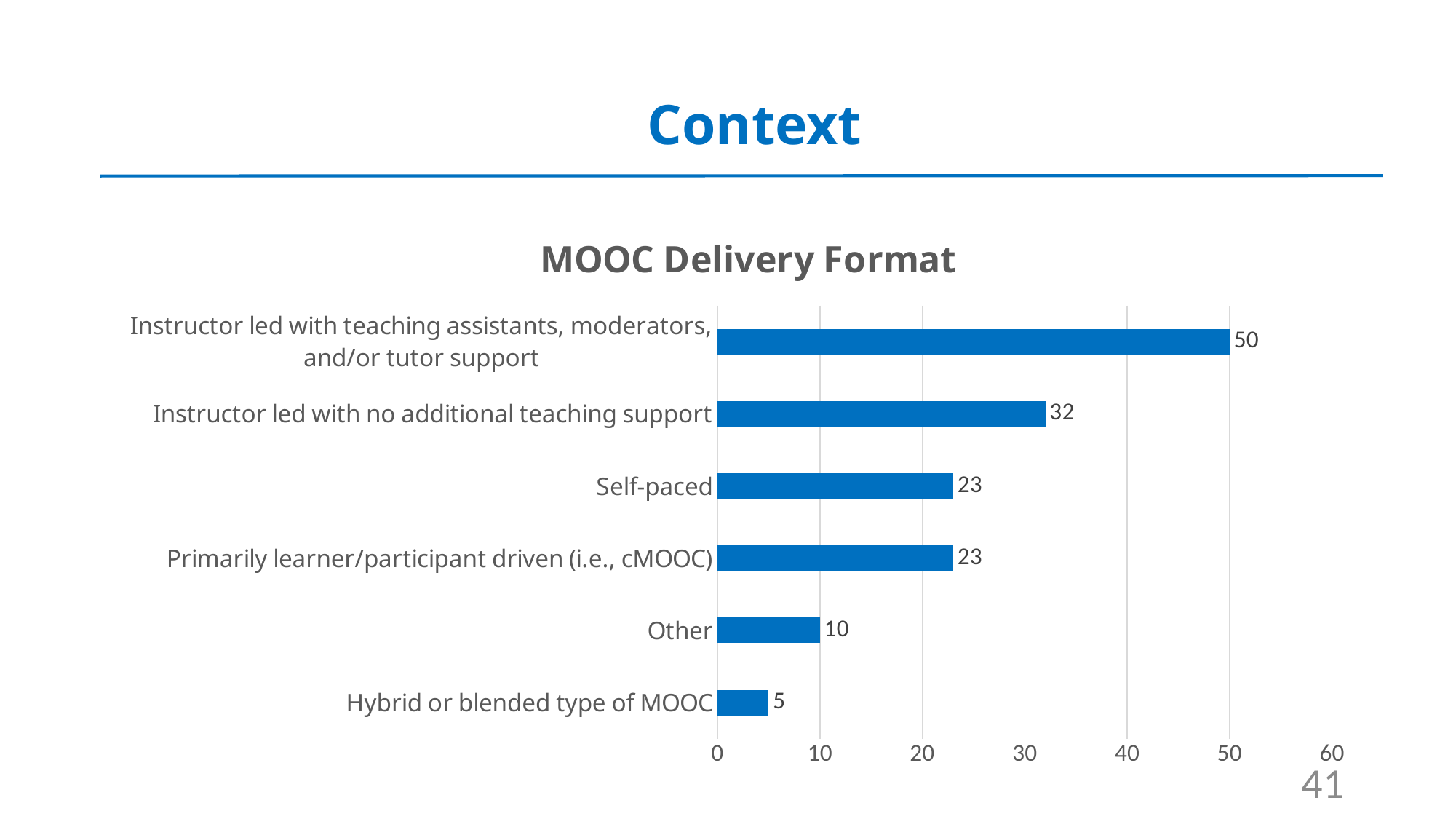
What is the difference between the values for Instructor led with teaching assistants, moderators, and/or tutor support and Instructor led with no additional teaching support? 18 Which category has the lowest value? Hybrid or blended type of MOOC What kind of chart is shown on the slide? bar chart Is the value for Instructor led with no additional teaching support greater or less than 40? less Which category has the highest value? Instructor led with teaching assistants, moderators, and/or tutor support Which is larger, the value for Other or the value for Hybrid or blended type of MOOC? Other How many categories are shown in the chart? 6 What is the value for Other? 10 What is the value for Instructor led with no additional teaching support? 32 What is the value for Self-paced? 23 What is the title of the chart? MOOC Delivery Format What is the value for Hybrid or blended type of MOOC? 5